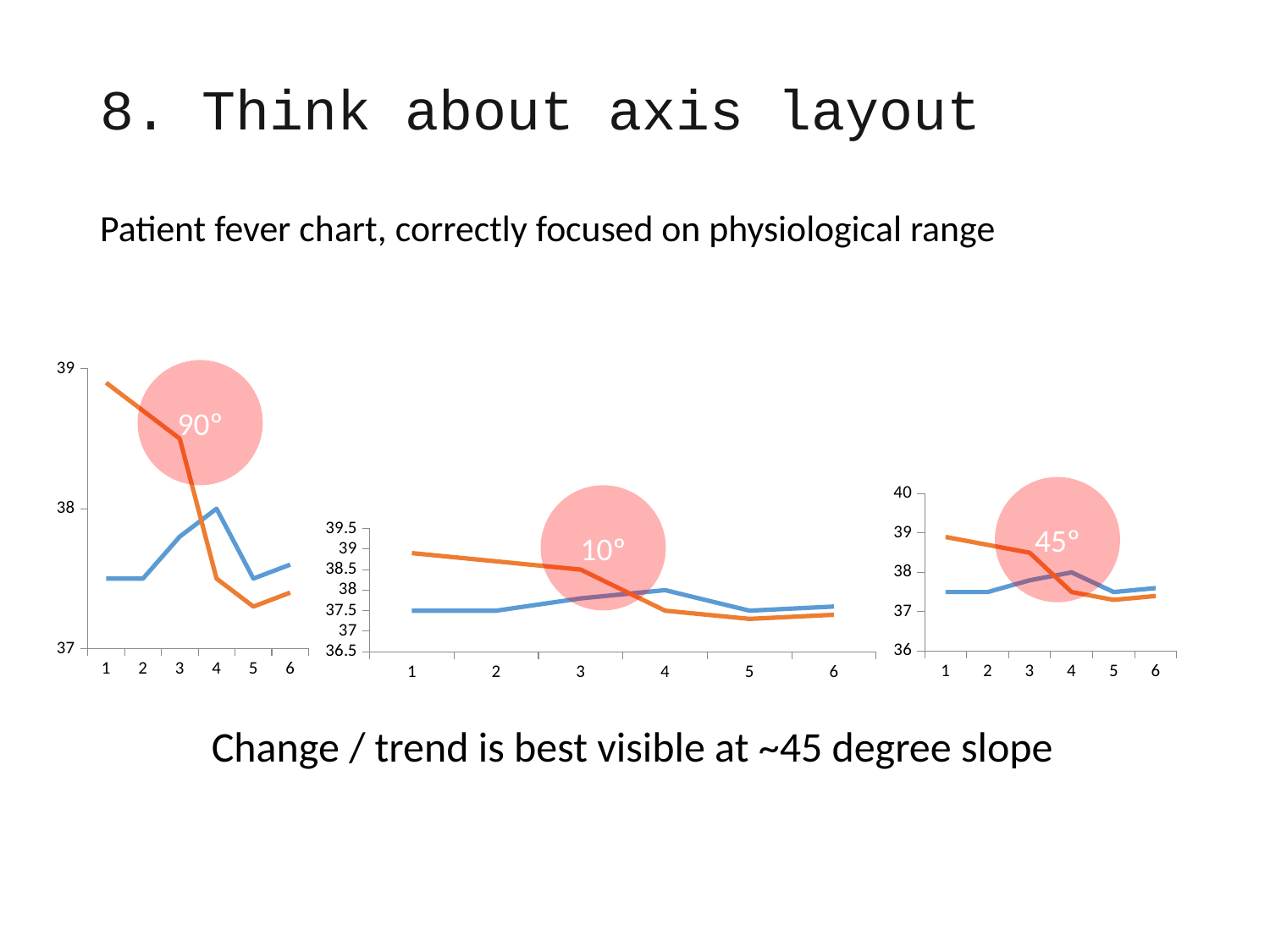
In the left chart, at point 5, which line has the higher value, the orange or the blue? blue In the middle chart, does the orange line rise or fall from point 1 to point 5? fall In the right chart, is the value of the blue line at point 1 greater or less than 38? less What is the lowest value shown on the y axis of the middle chart? 36.5 How many points are plotted along the x axis of the middle chart? 6 In the left chart, at point 1, which line has the higher value, the orange or the blue? orange In the left chart, at which x-axis point does the orange line reach its highest value? 1 In the left chart, is the value of the orange line at point 1 greater or less than 38? greater In the left chart, is the value of the orange line at point 5 greater or less than 38? less What label is written in the pink circle on the right chart? 45° How many lines are plotted in the right chart? 2 What kind of chart is the left chart on the slide? line chart